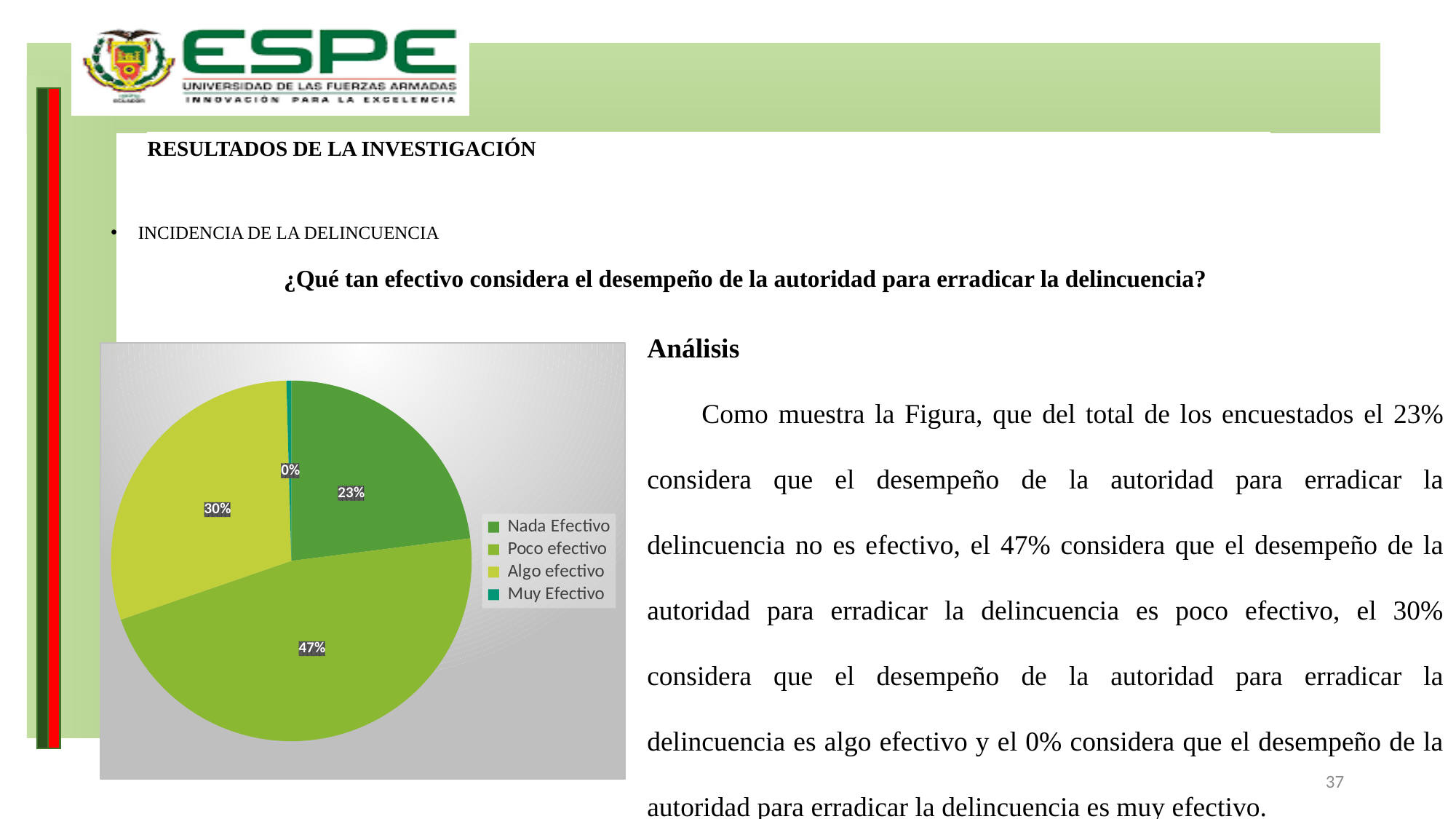
What kind of chart is shown on the slide? Pie chart What percentage of the pie corresponds to "Nada Efectivo"? 23% What percentage of the pie corresponds to "Poco efectivo"? 47% Which is larger, the slice for "Algo efectivo" or the slice for "Nada Efectivo"? Algo efectivo What is the difference in percentage points between "Poco efectivo" and "Nada Efectivo"? 24 How many categories does the legend of the pie chart list? 4 What percentage of the pie corresponds to "Muy Efectivo"? 0% What percentage of the pie corresponds to "Algo efectivo"? 30% Which legend entry is shown in the darkest green colour? Nada Efectivo What is the difference in percentage points between "Algo efectivo" and "Nada Efectivo"? 7 Which category has the largest slice of the pie? Poco efectivo Which category has the smallest slice of the pie? Muy Efectivo